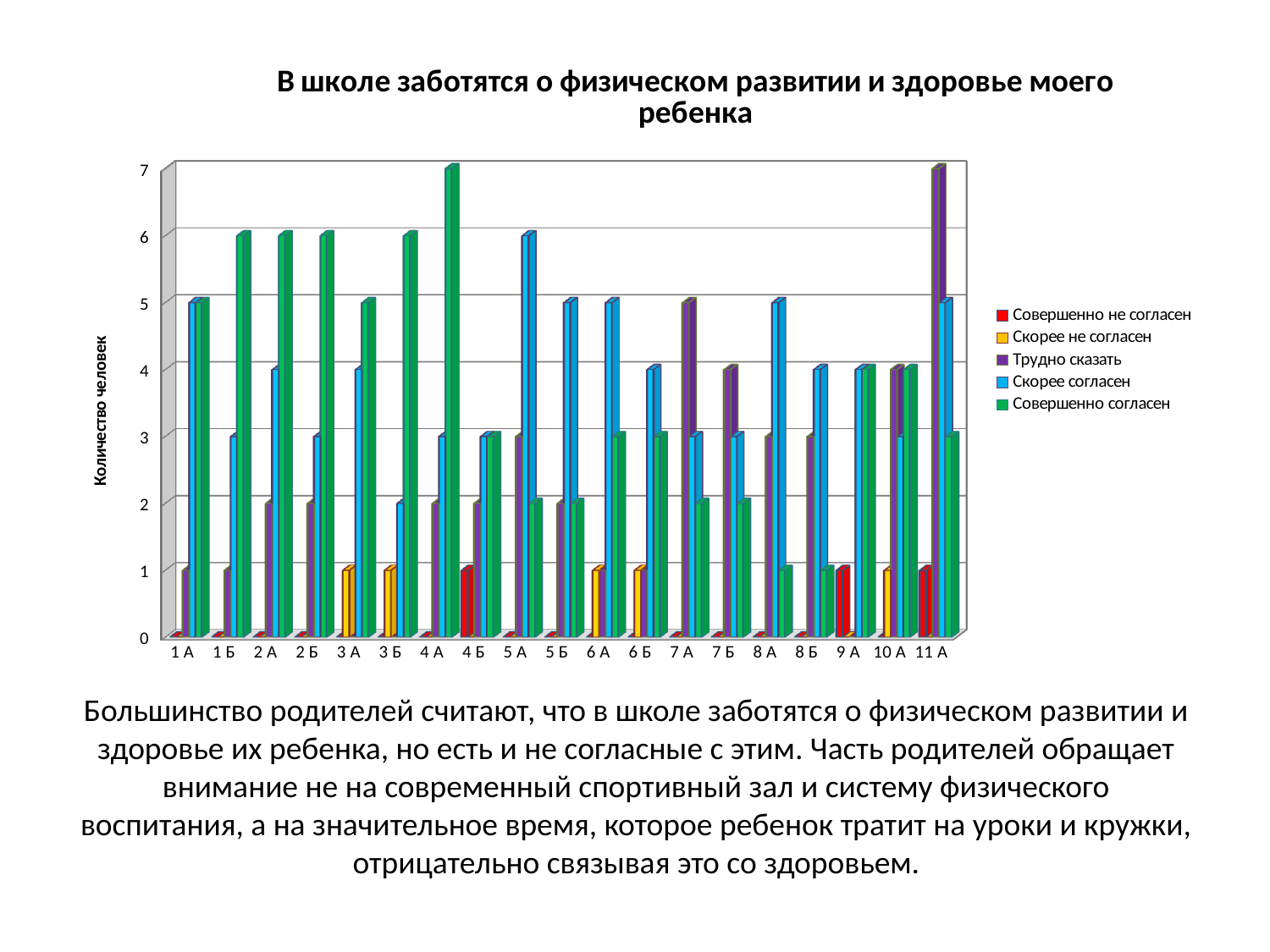
Which class has the highest value for the series "Совершенно согласен"? 4 А Is the value of "Скорее согласен" for 5 А greater or less than 5? greater How many series does the legend list? 5 For 7 А, which is larger: "Трудно сказать" or "Совершенно согласен"? Трудно сказать What kind of chart is shown on the slide? bar chart What is the label of the vertical axis? Количество человек For 1 Б, which is larger: "Скорее согласен" or "Совершенно согласен"? Совершенно согласен Is the value of "Совершенно согласен" for 8 А greater or less than 2? less Is the value of "Совершенно согласен" for 4 А greater or less than 6? greater Which class has the highest value for the series "Трудно сказать"? 11 А What is the title of the chart? В школе заботятся о физическом развитии и здоровье моего ребенка How many class categories are shown along the x axis? 19